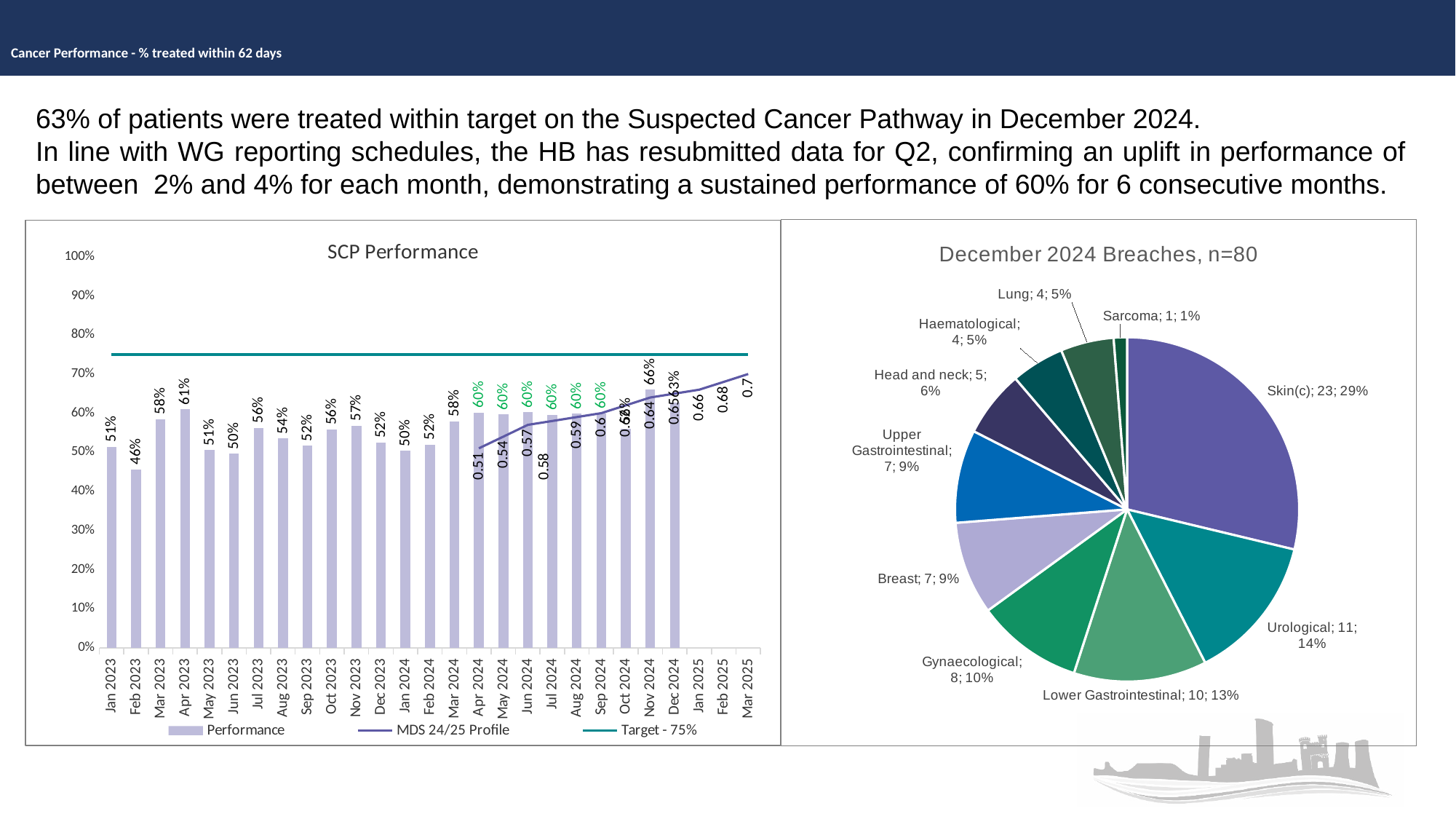
In the SCP Performance chart, what was the performance value for Apr 2023? 61% In the December 2024 Breaches chart, what share of breaches is Urological? 14% In the SCP Performance chart, which month has the lowest performance bar? Feb 2023 In the SCP Performance chart, what is the difference between the Nov 2024 and Feb 2023 performance values? 20% In the December 2024 Breaches chart, which category has the smallest slice? Sarcoma In the SCP Performance chart, what is the MDS 24/25 Profile value for Mar 2025? 0.7 In the SCP Performance chart, what was the performance value for Feb 2023? 46% How many slices does the December 2024 Breaches pie chart have? 10 How many series does the legend of the SCP Performance chart list? 3 In the December 2024 Breaches chart, how many breaches were Skin(c)? 23 In the SCP Performance chart, which month has the highest performance bar? Nov 2024 In the December 2024 Breaches chart, which has more breaches, Breast or Gynaecological? Gynaecological